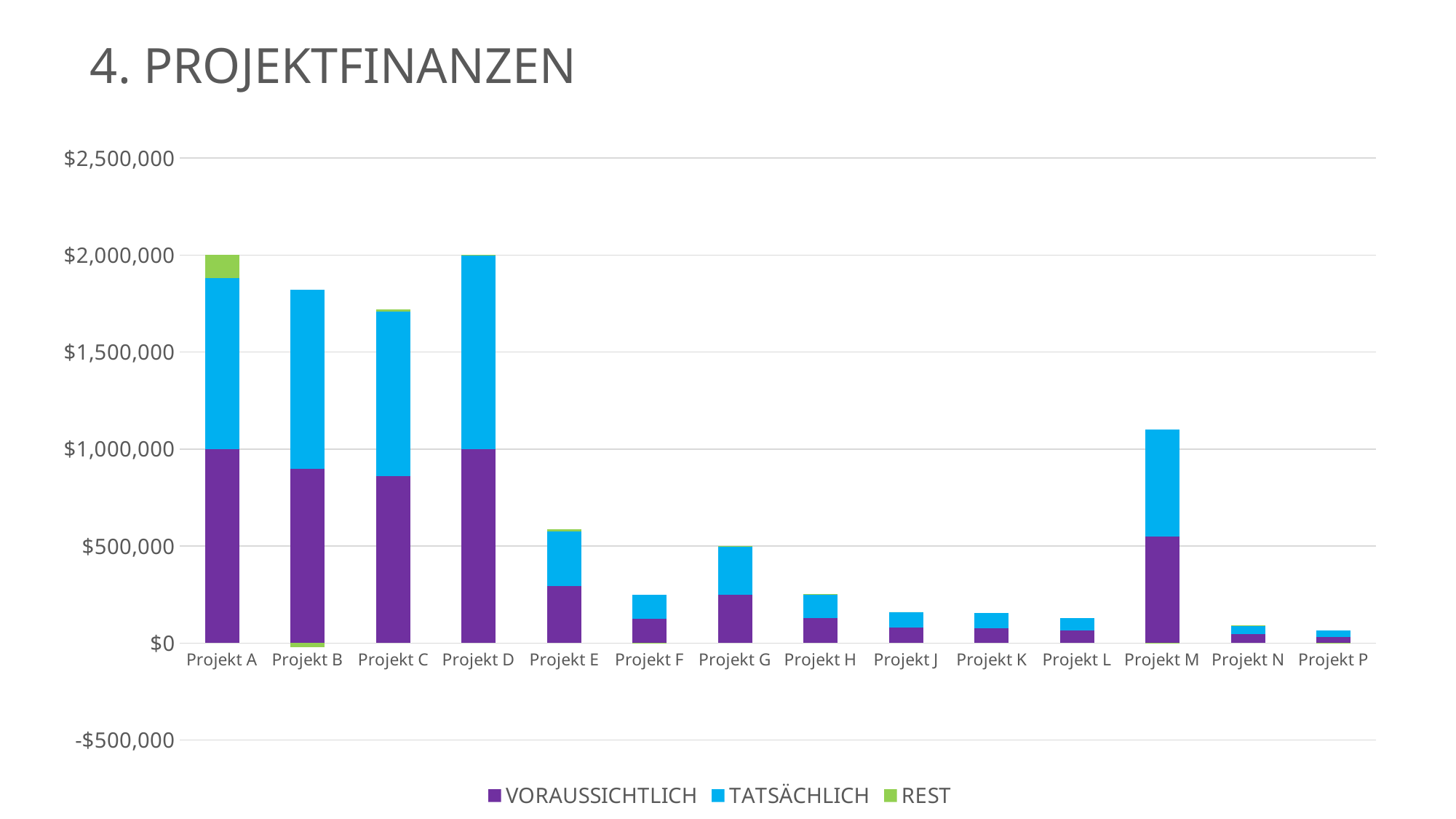
How many projects are shown on the x axis of the chart? 14 How many series does the chart's legend list? 3 Which project has the lowest total bar? Projekt P Is the total bar for Projekt F greater or less than $500,000? less What kind of chart is shown on the slide? Stacked bar chart Which has the larger total bar, Projekt M or Projekt E? Projekt M Is the total bar for Projekt C greater or less than $1,500,000? greater What is the VORAUSSICHTLICH value for Projekt A? $1,000,000 Which colour represents the REST series in the legend? Green Is the total bar for Projekt M greater or less than $1,000,000? greater Which has the larger total bar, Projekt B or Projekt C? Projekt B